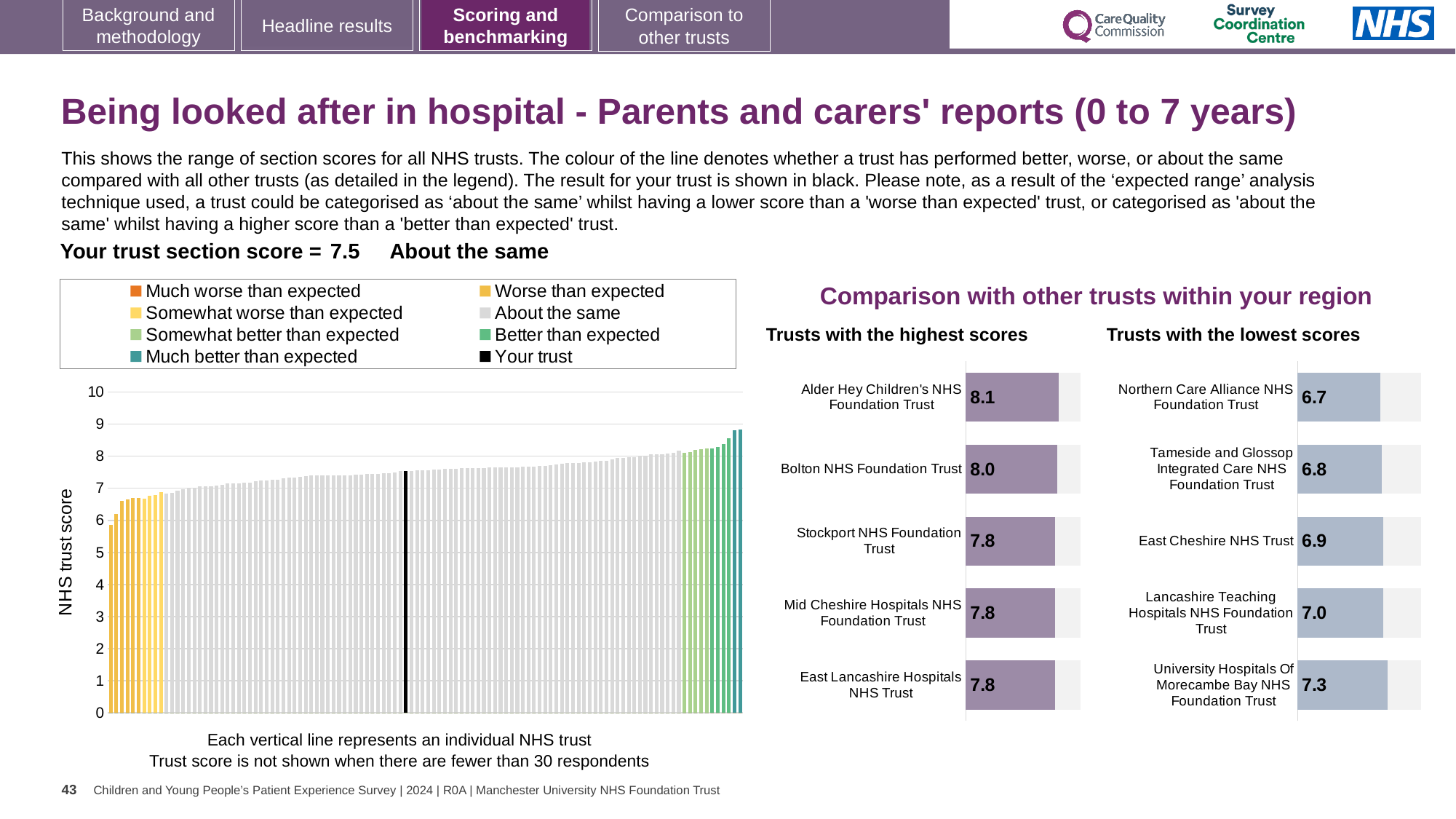
In the 'Trusts with the highest scores' chart, which trust has the highest score? Alder Hey Children's NHS Foundation Trust In the 'Trusts with the highest scores' chart, which has the larger score: Bolton NHS Foundation Trust or Stockport NHS Foundation Trust? Bolton NHS Foundation Trust How many entries does the legend above the large 'NHS trust score' chart list? 8 In the large 'NHS trust score' chart on the left, do the bar values rise or fall from left to right? Rise In the 'Trusts with the highest scores' chart, what is the difference between the scores of Alder Hey Children's NHS Foundation Trust and Bolton NHS Foundation Trust? 0.1 In the 'Trusts with the lowest scores' chart, what is the score for East Cheshire NHS Trust? 6.9 In the 'Trusts with the lowest scores' chart, which trust has the lowest score? Northern Care Alliance NHS Foundation Trust What kind of chart is the large 'NHS trust score' chart on the left of the slide? Bar chart In the 'Trusts with the lowest scores' chart, what is the difference between the scores of University Hospitals Of Morecambe Bay NHS Foundation Trust and Northern Care Alliance NHS Foundation Trust? 0.6 How many trusts are shown in the 'Trusts with the lowest scores' chart? 5 In the 'Trusts with the highest scores' chart, what is the score for Alder Hey Children's NHS Foundation Trust? 8.1 According to the slide, what is your trust's section score shown in black on the large chart? 7.5